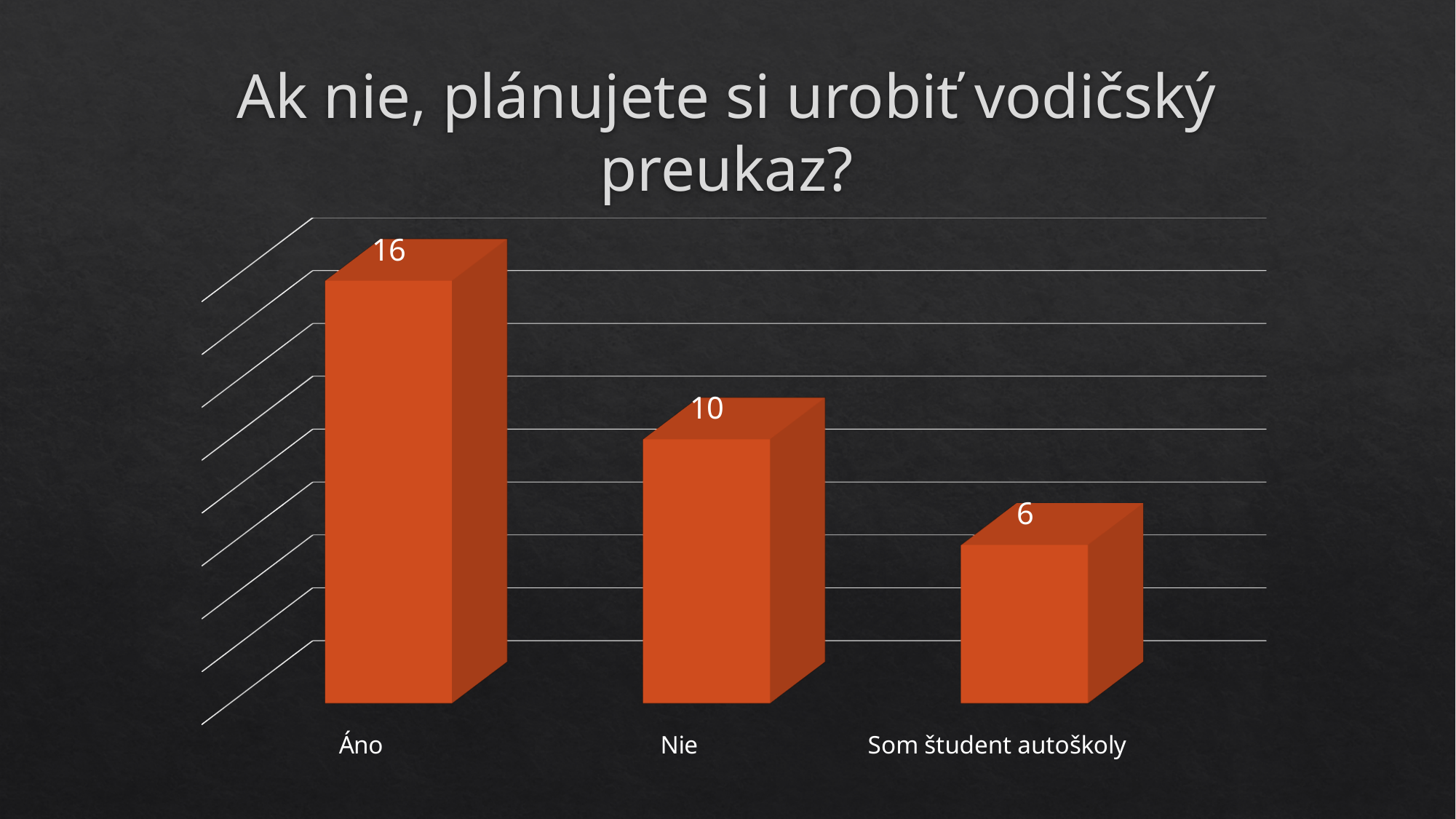
What is the title of the slide above the chart? Ak nie, plánujete si urobiť vodičský preukaz? Which category has the lowest value? Som študent autoškoly What is the value for Nie? 10 What is the difference between the values for Nie and Som študent autoškoly? 4 What is the value for Som študent autoškoly? 6 How many categories are shown in the chart? 3 What is the value for Áno? 16 Which is larger, the value for Nie or the value for Som študent autoškoly? Nie Do the values rise or fall from left to right across the categories? Fall What is the difference between the values for Áno and Nie? 6 What kind of chart is shown on the slide? Bar chart Which category has the highest value? Áno